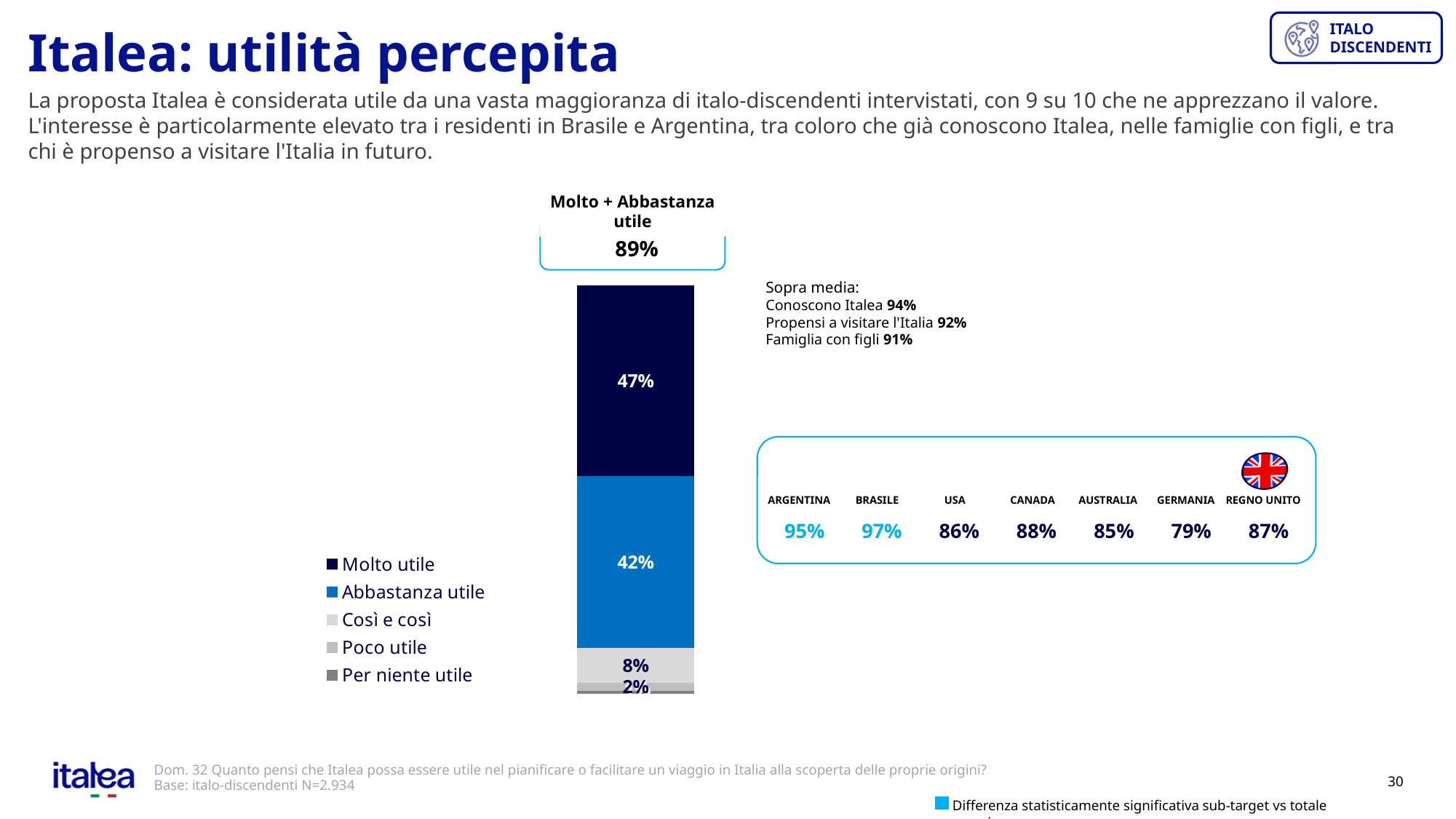
What is the difference between the "Molto utile" and "Abbastanza utile" values? 5% What is the combined value of "Molto utile" and "Abbastanza utile" shown above the bar as "Molto + Abbastanza utile"? 89% What is the value for "Abbastanza utile" in the stacked bar? 42% How many series does the chart legend list? 5 What is the value for "Molto utile" in the stacked bar? 47% Which segment of the stacked bar has the largest value? Molto utile What is the value for "Poco utile" in the stacked bar? 2% Which legend entry is shown in the darkest navy colour? Molto utile What is the value for "Così e così" in the stacked bar? 8% What is the difference between the "Abbastanza utile" and "Così e così" values? 34% Which is larger, the "Molto utile" segment or the "Abbastanza utile" segment? Molto utile What kind of chart is shown on the slide? Stacked bar chart